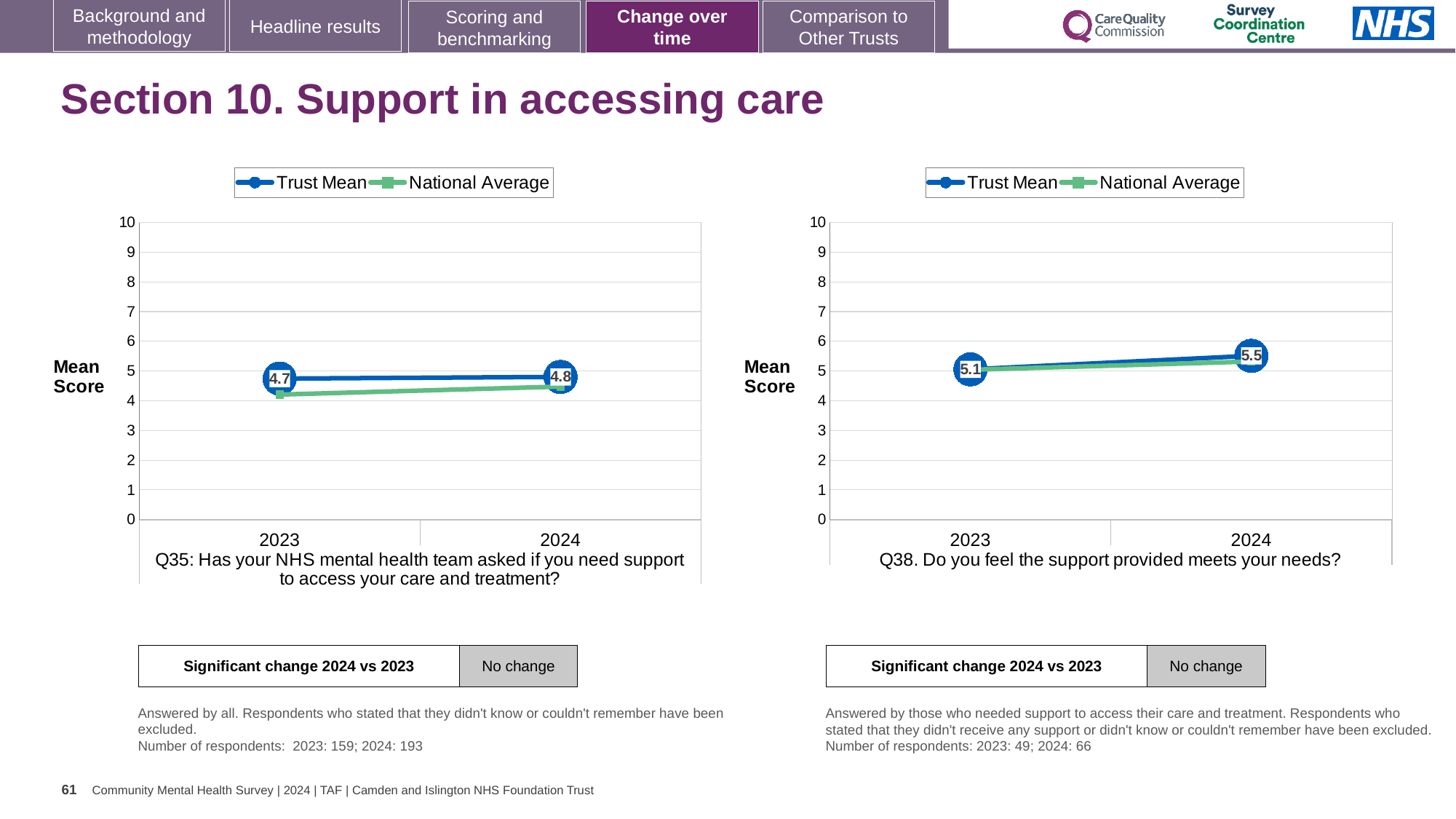
How many series does the legend of the Q35 chart on the left list? 2 In the Q35 chart on the left, what is the Trust Mean score for 2024? 4.8 What is the maximum value shown on the y axis of the Q35 chart on the left? 10 In the Q38 chart on the right, what is the Trust Mean score for 2023? 5.1 What kind of chart is the Q38 chart on the right? line chart How many years are plotted on the x axis of the Q38 chart on the right? 2 In the Q35 chart on the left, which series has the higher value in 2023, Trust Mean or National Average? Trust Mean In the Q35 chart on the left, what is the Trust Mean score for 2023? 4.7 In the Q38 chart on the right, by how much did the Trust Mean change from 2023 to 2024? 0.4 In the Q35 chart on the left, is the National Average value for 2023 greater or less than 5? less In the Q38 chart on the right, what is the Trust Mean score for 2024? 5.5 In the Q35 chart on the left, does the Trust Mean rise or fall from 2023 to 2024? rise